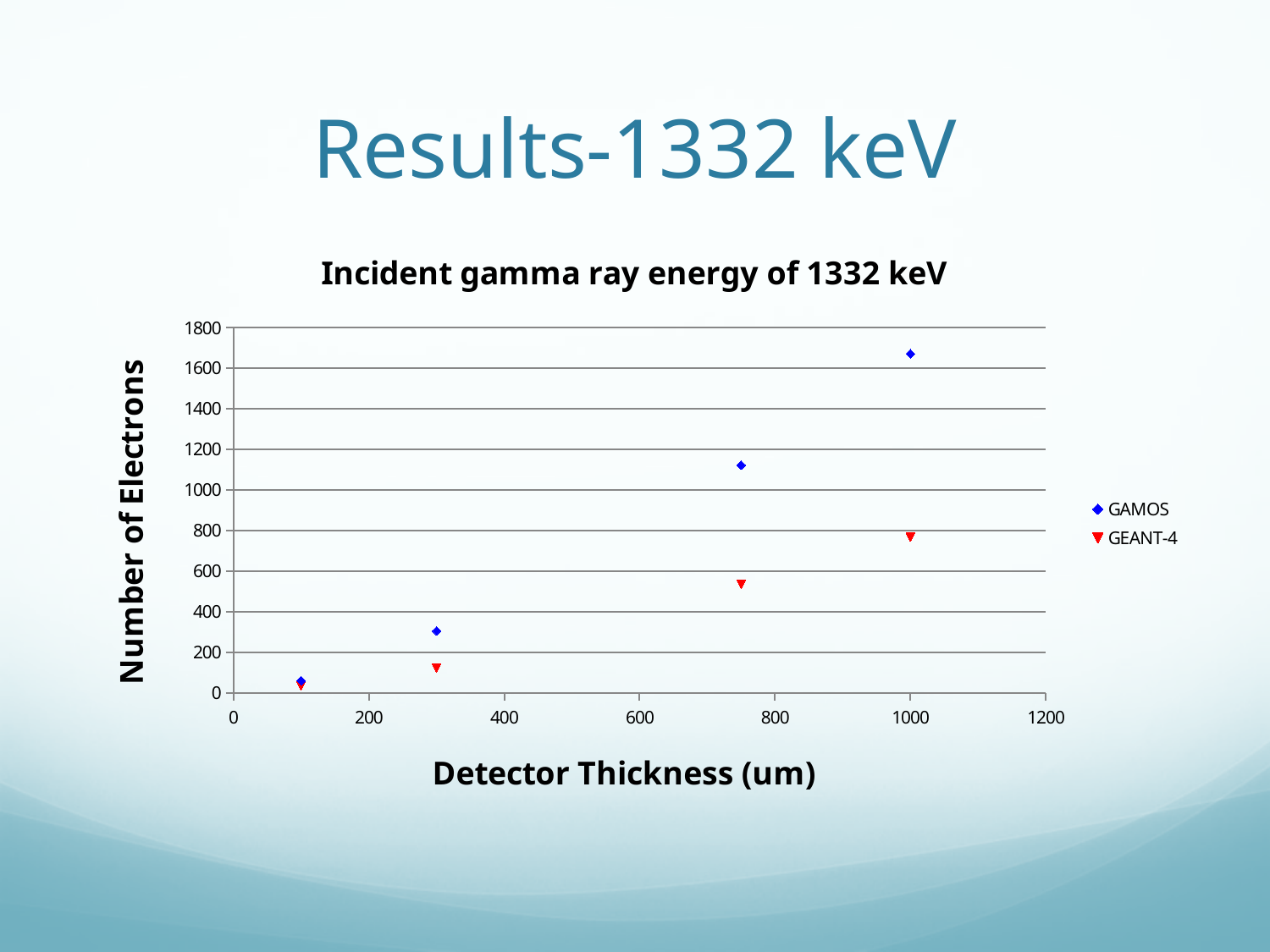
What kind of chart is shown on the slide? Scatter chart Is the GEANT-4 value at a detector thickness of 1000 um greater or less than 600? greater Do the GEANT-4 values rise or fall as detector thickness increases? Rise At a detector thickness of 1000 um, which series has the larger number of electrons, GAMOS or GEANT-4? GAMOS How many series does the legend list? 2 Is the GAMOS value at a detector thickness of about 750 um greater or less than 1000? greater What is the title of the chart? Incident gamma ray energy of 1332 keV Is the GEANT-4 value at a detector thickness of about 750 um greater or less than 600? less What are the two series named in the legend? GAMOS and GEANT-4 How many data points are plotted for the GAMOS series? 4 At which detector thickness does the GAMOS series reach its highest number of electrons? 1000